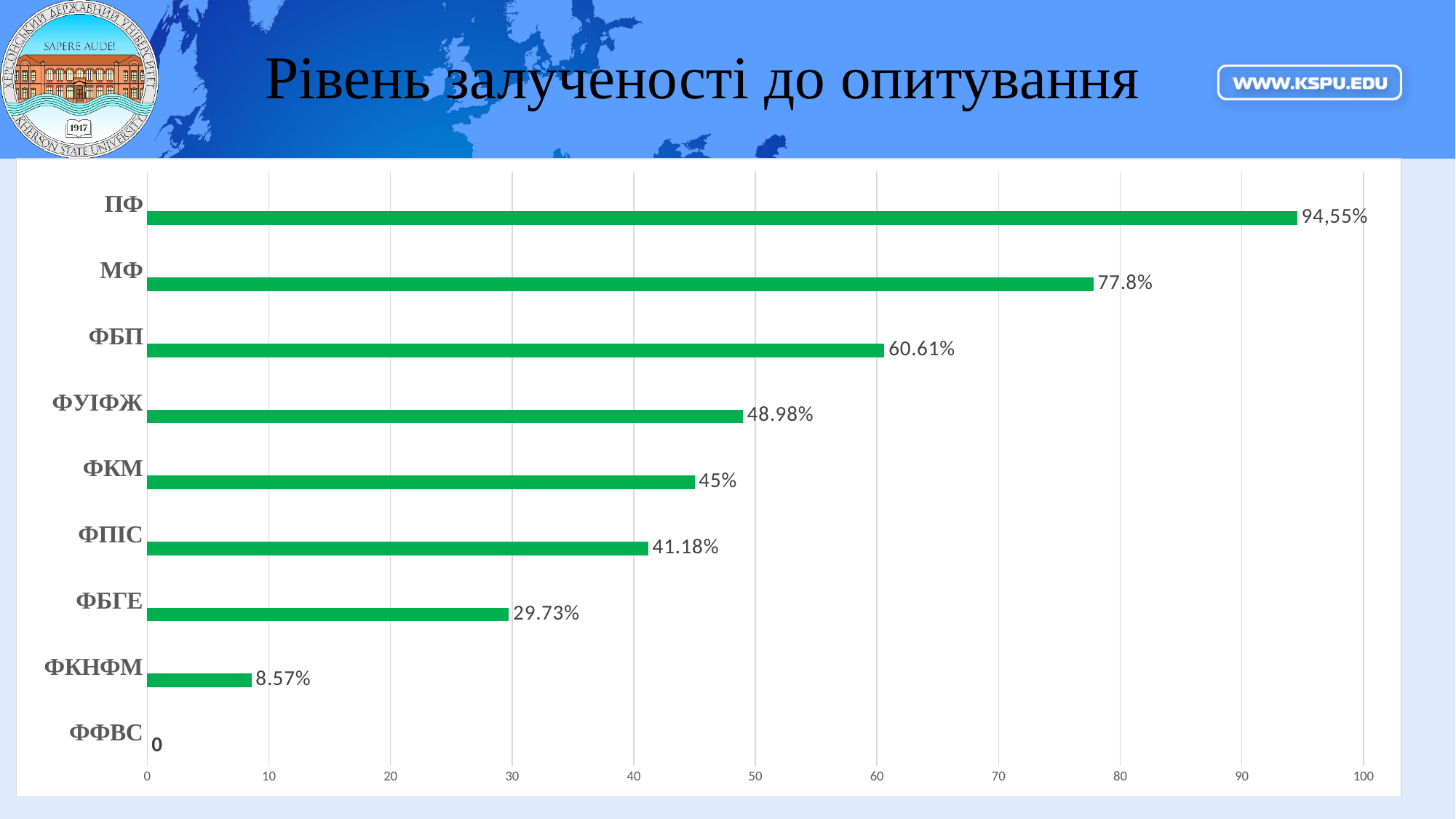
What is the difference between the values for ФБП and ФУІФЖ? 11.63% What is the title of the slide? Рівень залученості до опитування What is the value for ФБП? 60.61% Which category has the lowest value? ФФВС Which is larger, the value for МФ or the value for ФКМ? МФ What is the difference between the values for ФБГЕ and ФКНФМ? 21.16% What is the value for ФФВС? 0 What kind of chart is shown on the slide? Bar chart What is the value for ПФ? 94,55% What is the value for ФКНФМ? 8.57% How many categories are shown in the chart? 9 Which category has the highest value? ПФ